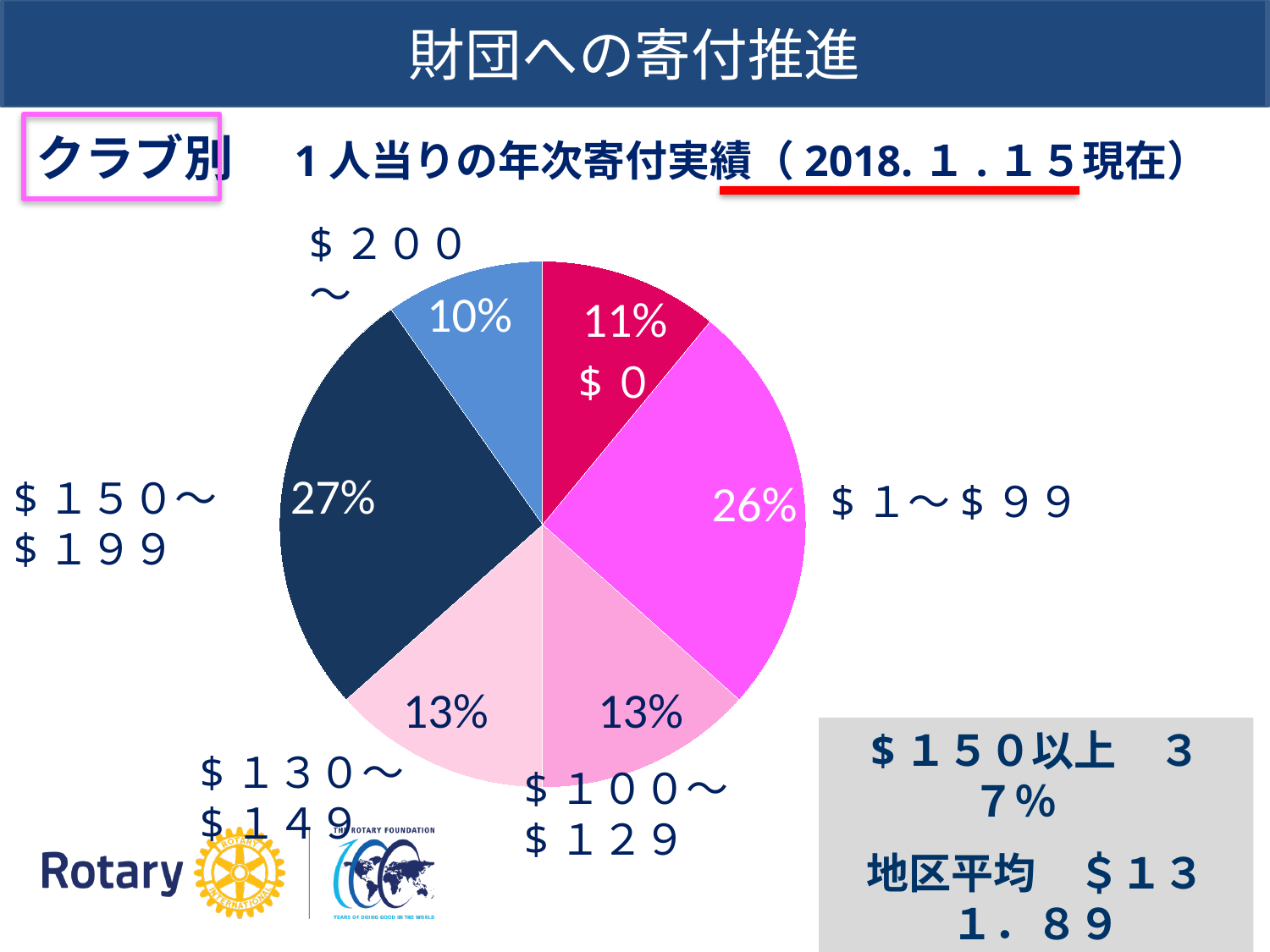
Which slice of the pie chart is the smallest? $200～ What share of the pie is the $200～ slice? 10% What share of the pie is the $0 slice? 11% What share of the pie is the $100～$129 slice? 13% What is the difference in percentage points between the $1～$99 slice and the $0 slice? 15% Which slice of the pie chart is the largest? $150～$199 What kind of chart is shown on the slide? pie chart Which is larger, the $150～$199 slice or the $1～$99 slice? $150～$199 What colour is the $150～$199 slice? dark navy blue How many slices does the pie chart have? 6